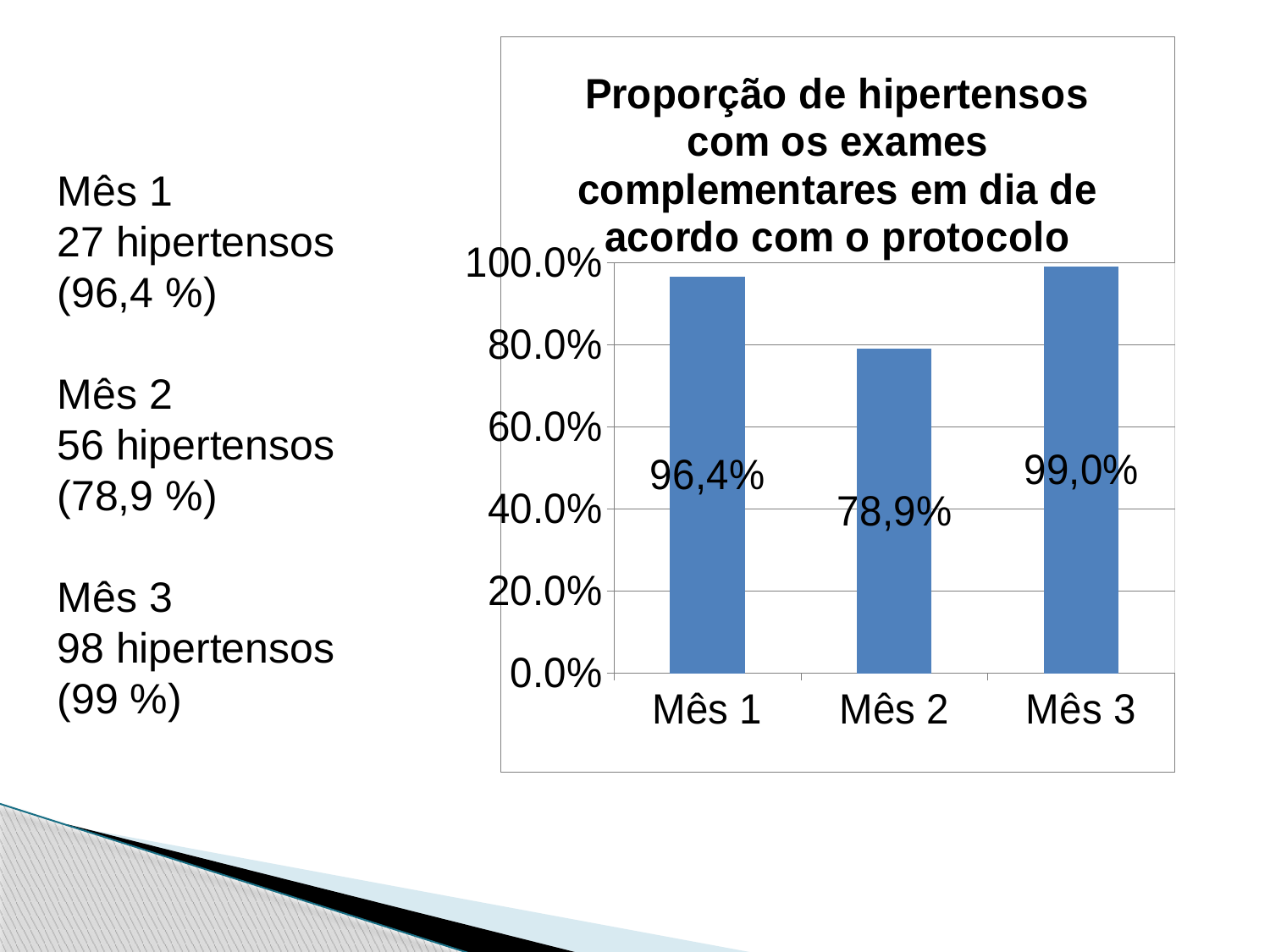
Which is larger, the value for Mês 1 or the value for Mês 2? Mês 1 How many months are shown on the x axis? 3 What is the difference between the values for Mês 3 and Mês 2? 20,1% What is the value for Mês 3? 99,0% What is the title of the chart? Proporção de hipertensos com os exames complementares em dia de acordo com o protocolo What kind of chart is shown on the slide? Bar chart What is the difference between the values for Mês 1 and Mês 2? 17,5% Which month has the highest value? Mês 3 Is the value for Mês 2 greater or less than 80.0%? less What is the value for Mês 1? 96,4% What is the value for Mês 2? 78,9% Which month has the lowest value? Mês 2